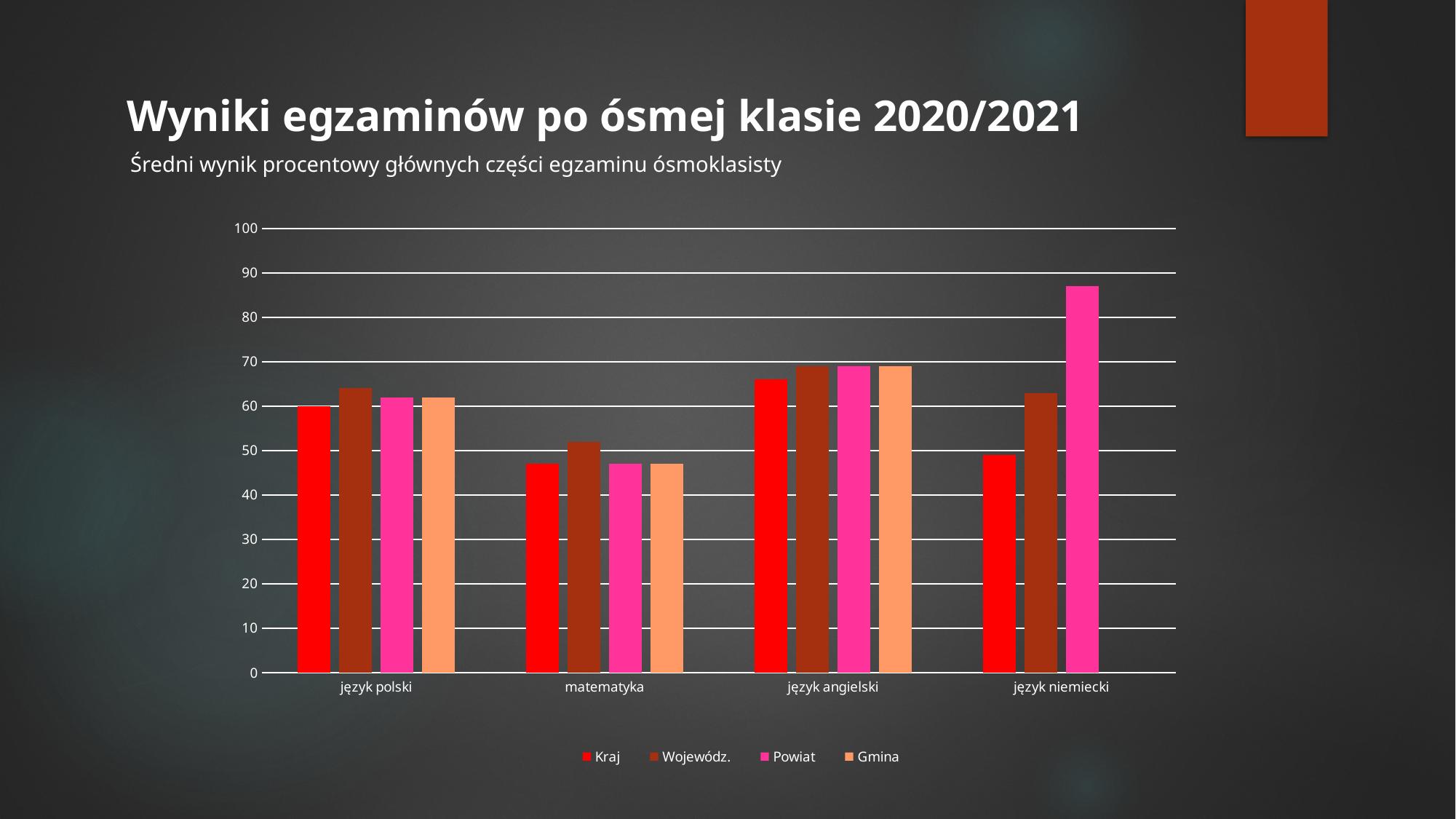
How many series does the legend list? 4 What kind of chart is shown on the slide? bar chart Which is larger, the Kraj value for język angielski or the Kraj value for język niemiecki? język angielski Is the Kraj value for matematyka greater or less than 50? less Which series has the larger value for język polski, Kraj or Wojewódz.? Wojewódz. Which series has no bar for język niemiecki? Gmina For which subject is the Kraj bar the lowest? matematyka How many subject categories are shown on the x axis? 4 Is the Wojewódz. value for matematyka greater or less than 50? greater Is the Powiat value for język niemiecki greater or less than 80? greater For which subject is the Powiat bar the highest? język niemiecki